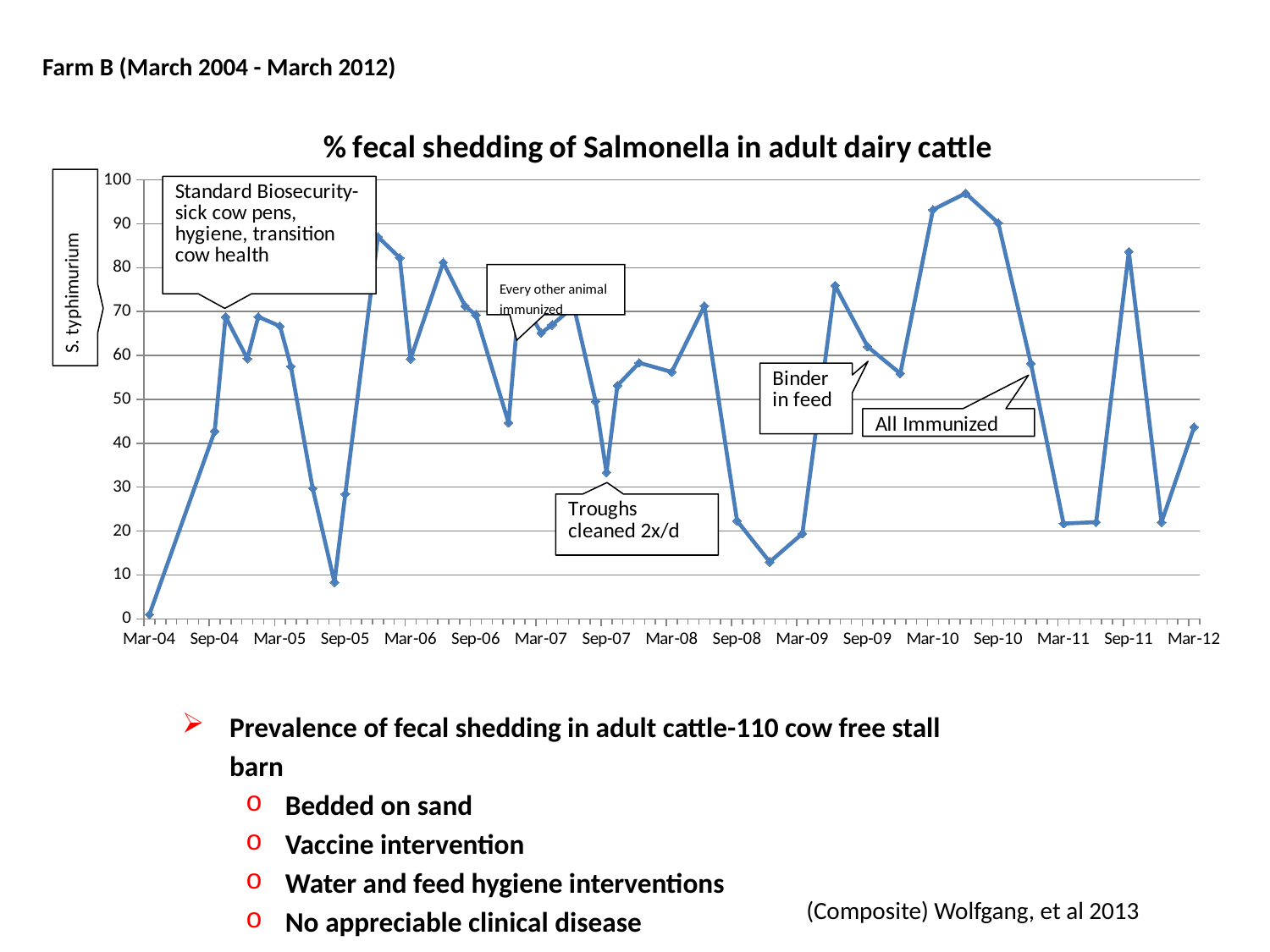
What is the label on the vertical axis of the chart? S. typhimurium Is the value at Sep-08 greater or less than 30? less Which date on the x axis has the lowest plotted value? Mar-04 Does the line rise or fall between Mar-10 and Mar-11? fall What kind of chart is shown on the slide? line chart Is the value at Mar-10 greater or less than 80? greater What is the title of the chart? % fecal shedding of Salmonella in adult dairy cattle Is the value at Sep-11 greater or less than 70? greater How many data series are plotted on the chart? 1 Which is larger, the value at Mar-10 or the value at Mar-11? Mar-10